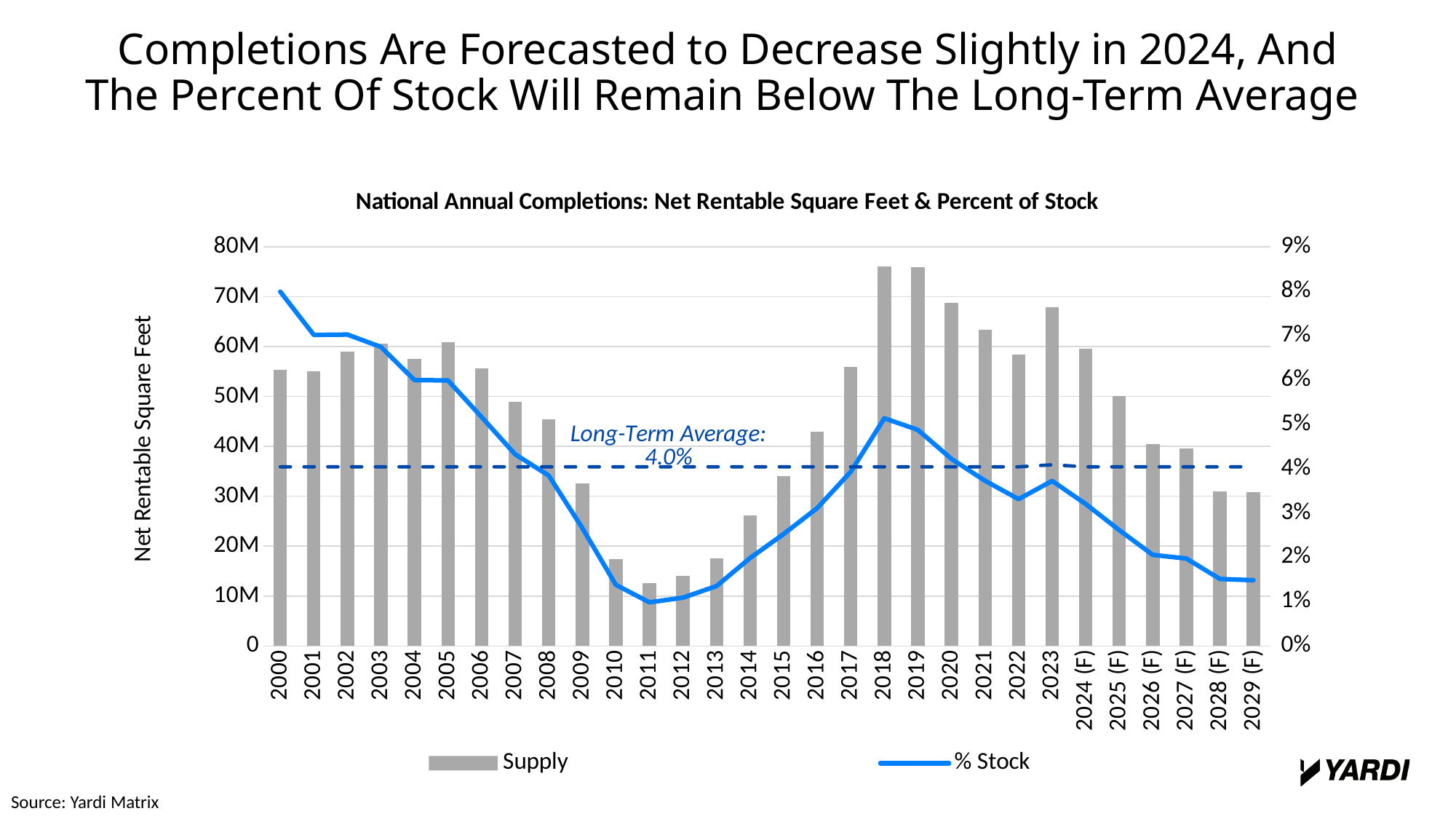
How many years are shown on the x axis? 30 Does the % Stock line rise or fall from 2000 to 2011? fall What kind of chart is shown on the slide? Combination bar and line chart Which year has the larger Supply value, 2016 or 2017? 2017 What value is given for the Long-Term Average of percent of stock? 4.0% Which year has the lowest Supply bar? 2011 Which year has the highest % Stock value? 2000 Is the % Stock value for 2029 (F) greater or less than 2%? less What is the title of the chart? National Annual Completions: Net Rentable Square Feet & Percent of Stock Is the Supply value for 2011 greater or less than 20M? less Is the Supply value for 2018 greater or less than 70M? greater How many series does the legend list? 2